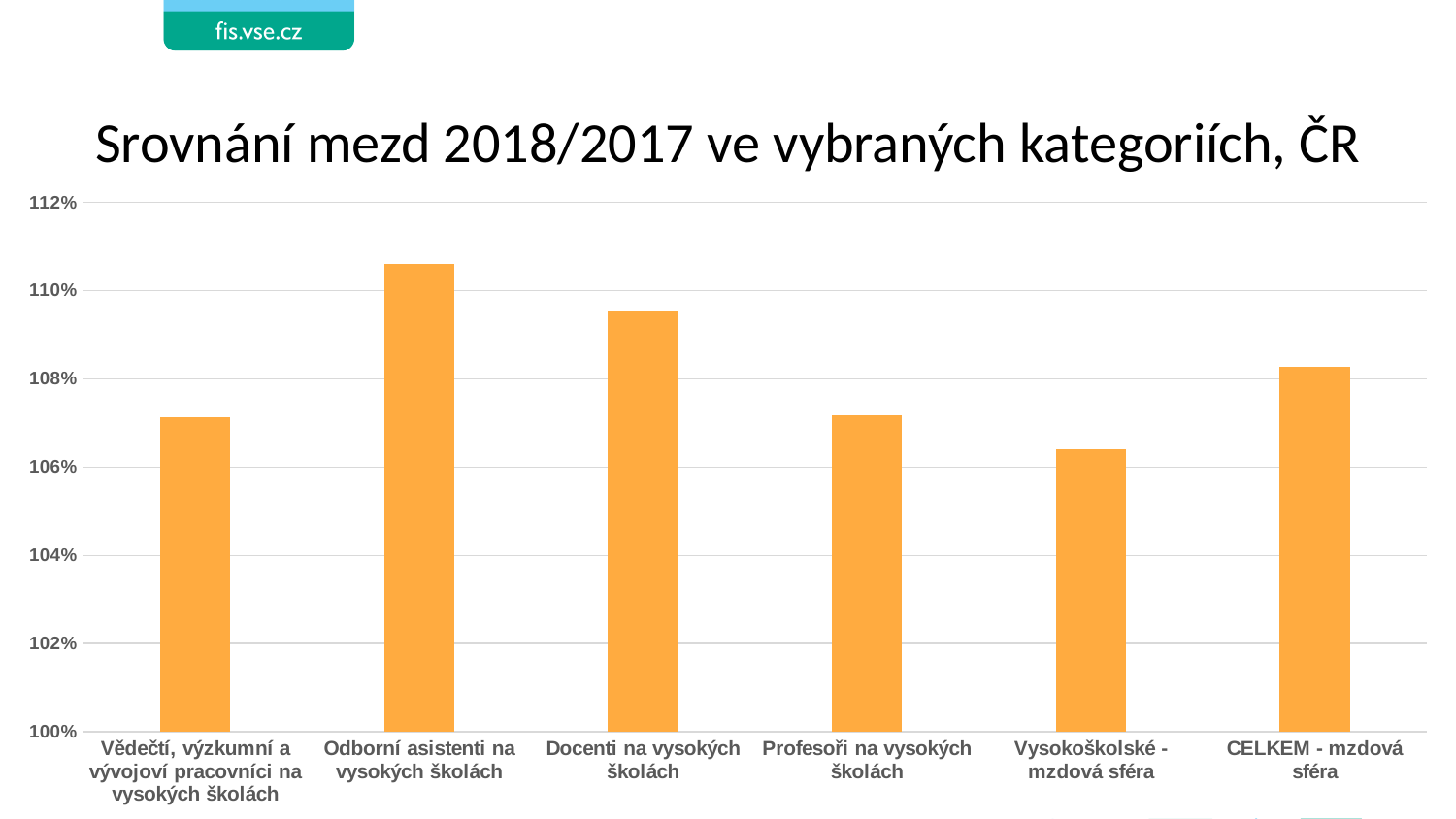
Which category has the lowest value in the chart? Vysokoškolské - mzdová sféra How many categories are shown on the x axis of the chart? 6 Which is larger, the value for Vědečtí, výzkumní a vývojoví pracovníci na vysokých školách or the value for Vysokoškolské - mzdová sféra? Vědečtí, výzkumní a vývojoví pracovníci na vysokých školách What is the title of the chart? Srovnání mezd 2018/2017 ve vybraných kategoriích, ČR Which is larger, the value for Docenti na vysokých školách or the value for CELKEM - mzdová sféra? Docenti na vysokých školách Is the value for Docenti na vysokých školách greater or less than 110%? less Which category has the highest value in the chart? Odborní asistenti na vysokých školách What type of chart is shown on the slide? bar chart Is the value for Profesoři na vysokých školách greater or less than 108%? less Is the value for CELKEM - mzdová sféra greater or less than 108%? greater